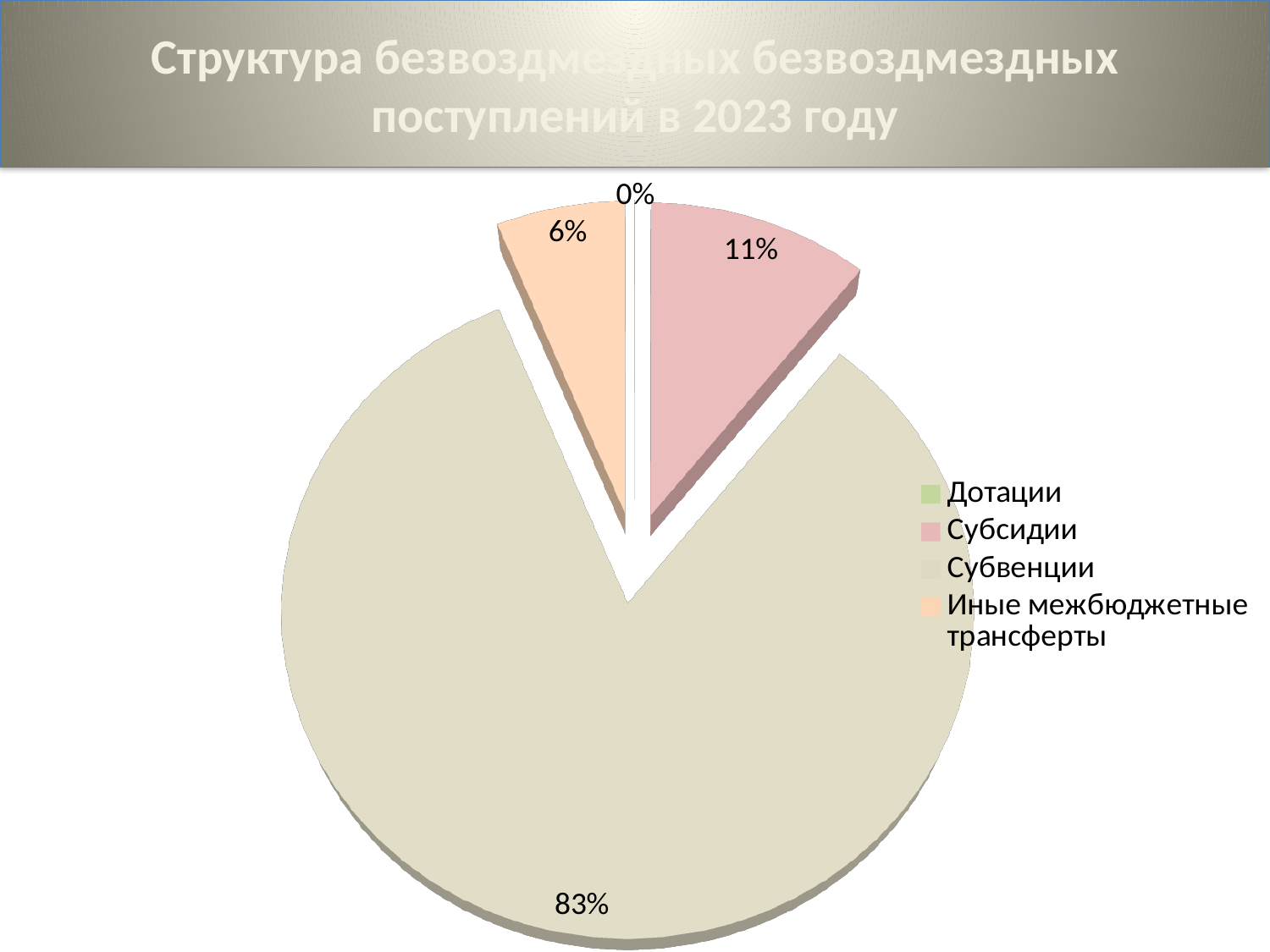
What is the title of the chart? Структура безвоздмездных безвоздмездных поступлений в 2023 году Which category has the smallest share of the pie? Дотации What type of chart is shown on the slide? Pie chart What share of the pie does Дотации have? 0% Which category has the largest share of the pie? Субвенции What share of the pie does Субвенции have? 83% Which category is shown in pink in the legend? Субсидии What share of the pie does Субсидии have? 11% What is the difference between the share for Субвенции and the share for Субсидии? 72% Which is larger, the share for Субсидии or the share for Иные межбюджетные трансферты? Субсидии How many categories does the legend list? 4